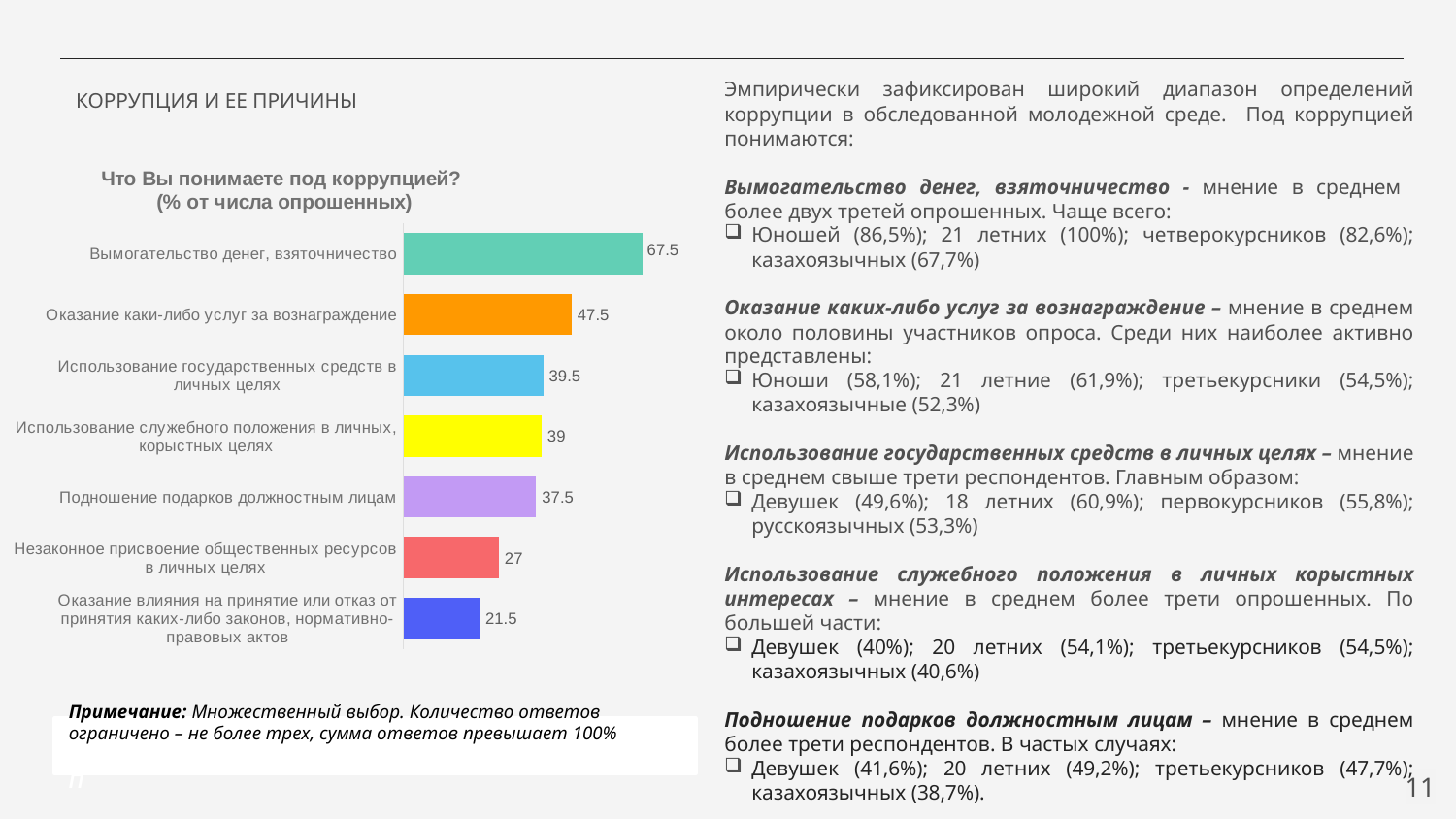
What type of chart is shown on the slide? Bar chart What value is shown for «Оказание влияния на принятие или отказ от принятия каких-либо законов, нормативно-правовых актов»? 21.5 What value is shown for «Незаконное присвоение общественных ресурсов в личных целях»? 27 What is the difference between the values for «Использование государственных средств в личных целях» and «Использование служебного положения в личных, корыстных целях»? 0.5 What is the title of the chart? Что Вы понимаете под коррупцией? (% от числа опрошенных) How many categories are shown in the chart? 7 Which category has the lowest value? Оказание влияния на принятие или отказ от принятия каких-либо законов, нормативно-правовых актов Which category has the highest value? Вымогательство денег, взяточничество What value is shown for «Вымогательство денег, взяточничество»? 67.5 Which is larger: the value for «Оказание каки-либо услуг за вознаграждение» or for «Подношение подарков должностным лицам»? Оказание каки-либо услуг за вознаграждение What is the difference between the values for «Вымогательство денег, взяточничество» and «Оказание каки-либо услуг за вознаграждение»? 20 What value is shown for «Подношение подарков должностным лицам»? 37.5